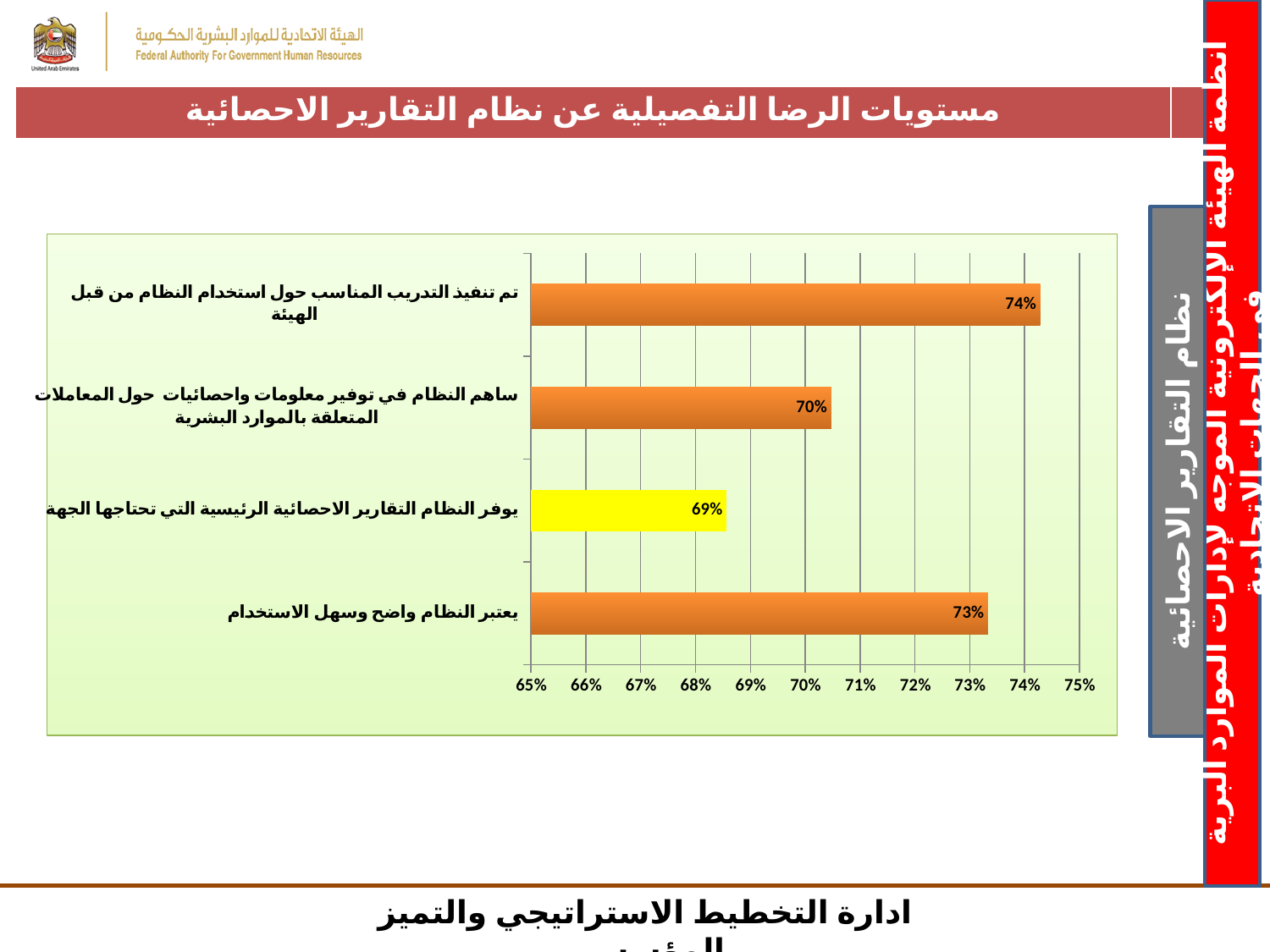
What is the value for "تم تنفيذ التدريب المناسب حول استخدام النظام من قبل الهيئة"? 74% Which category has the lowest value? يوفر النظام التقارير الاحصائية الرئيسية التي تحتاجها الجهة Which category has the highest value? تم تنفيذ التدريب المناسب حول استخدام النظام من قبل الهيئة Which category's bar is coloured yellow instead of orange? يوفر النظام التقارير الاحصائية الرئيسية التي تحتاجها الجهة Is the value for "يوفر النظام التقارير الاحصائية الرئيسية التي تحتاجها الجهة" greater or less than 70%? less What is the value for "يعتبر النظام واضح وسهل الاستخدام"? 73% Which is larger: the value for "يعتبر النظام واضح وسهل الاستخدام" or the value for "ساهم النظام في توفير معلومات واحصائيات حول المعاملات المتعلقة بالموارد البشرية"? يعتبر النظام واضح وسهل الاستخدام What kind of chart is shown on the slide? bar chart What is the value for "ساهم النظام في توفير معلومات واحصائيات حول المعاملات المتعلقة بالموارد البشرية"? 70% What is the difference between the highest value (74%) and the lowest value (69%)? 5% What is the value for "يوفر النظام التقارير الاحصائية الرئيسية التي تحتاجها الجهة"? 69% How many categories are shown in the chart? 4